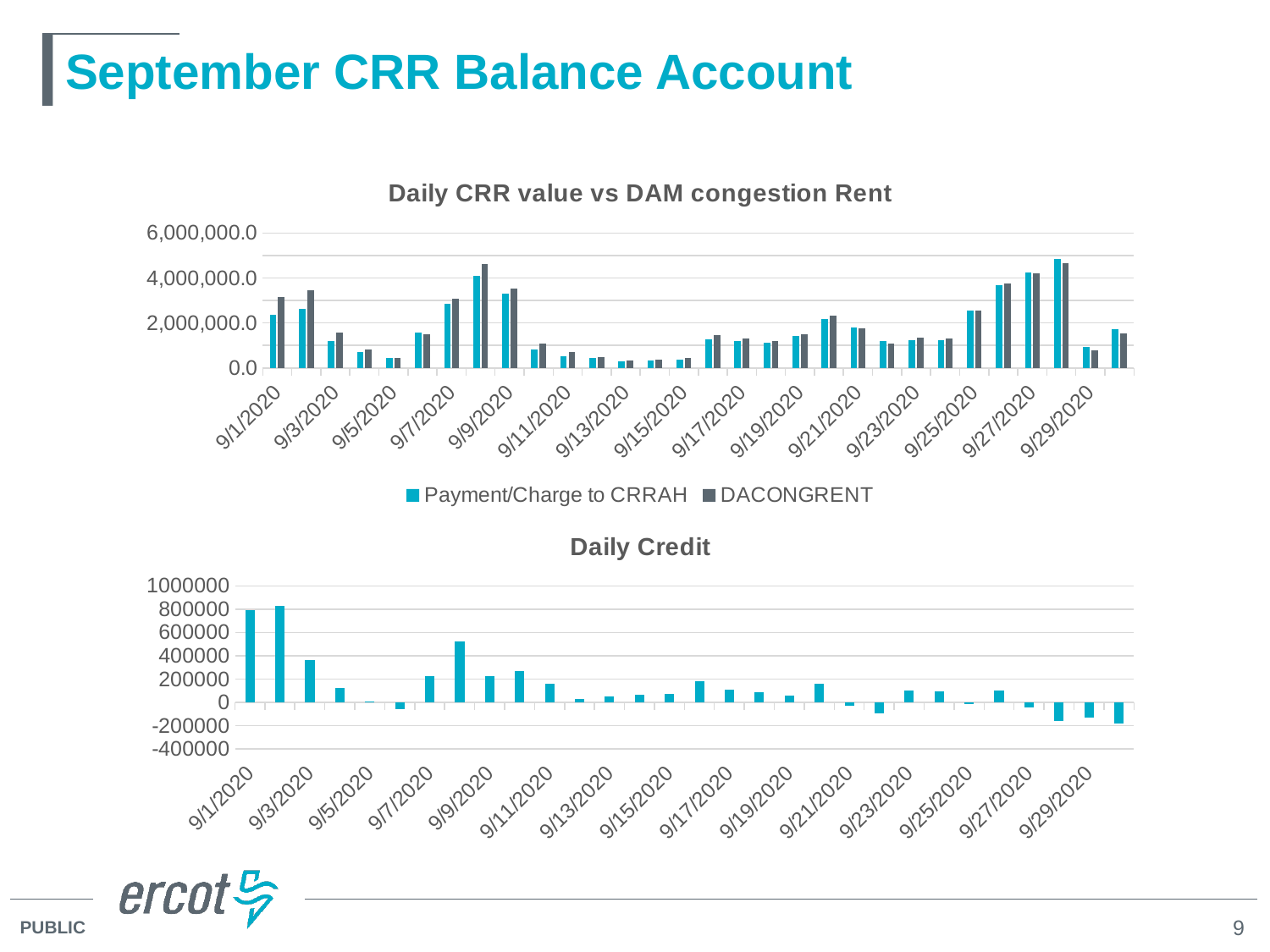
In the "Daily CRR value vs DAM congestion Rent" chart, what are the two series named in the legend? Payment/Charge to CRRAH and DACONGRENT In the "Daily CRR value vs DAM congestion Rent" chart, is the DACONGRENT value for 9/9/2020 greater or less than 2,000,000.0? greater In the "Daily CRR value vs DAM congestion Rent" chart, is the Payment/Charge to CRRAH value for 9/1/2020 greater or less than 2,000,000.0? greater What kind of chart is the "Daily CRR value vs DAM congestion Rent" chart? Bar chart In the "Daily CRR value vs DAM congestion Rent" chart, is the DACONGRENT value for 9/13/2020 greater or less than 2,000,000.0? less What kind of chart is the "Daily Credit" chart? Bar chart In the "Daily Credit" chart, which is larger: the value for 9/3/2020 or the value for 9/5/2020? 9/3/2020 How many series does the legend of the "Daily CRR value vs DAM congestion Rent" chart list? 2 In the "Daily CRR value vs DAM congestion Rent" chart, which is larger for 9/1/2020: Payment/Charge to CRRAH or DACONGRENT? DACONGRENT In the "Daily Credit" chart, do the values generally rise or fall from 9/1/2020 to 9/29/2020? Fall